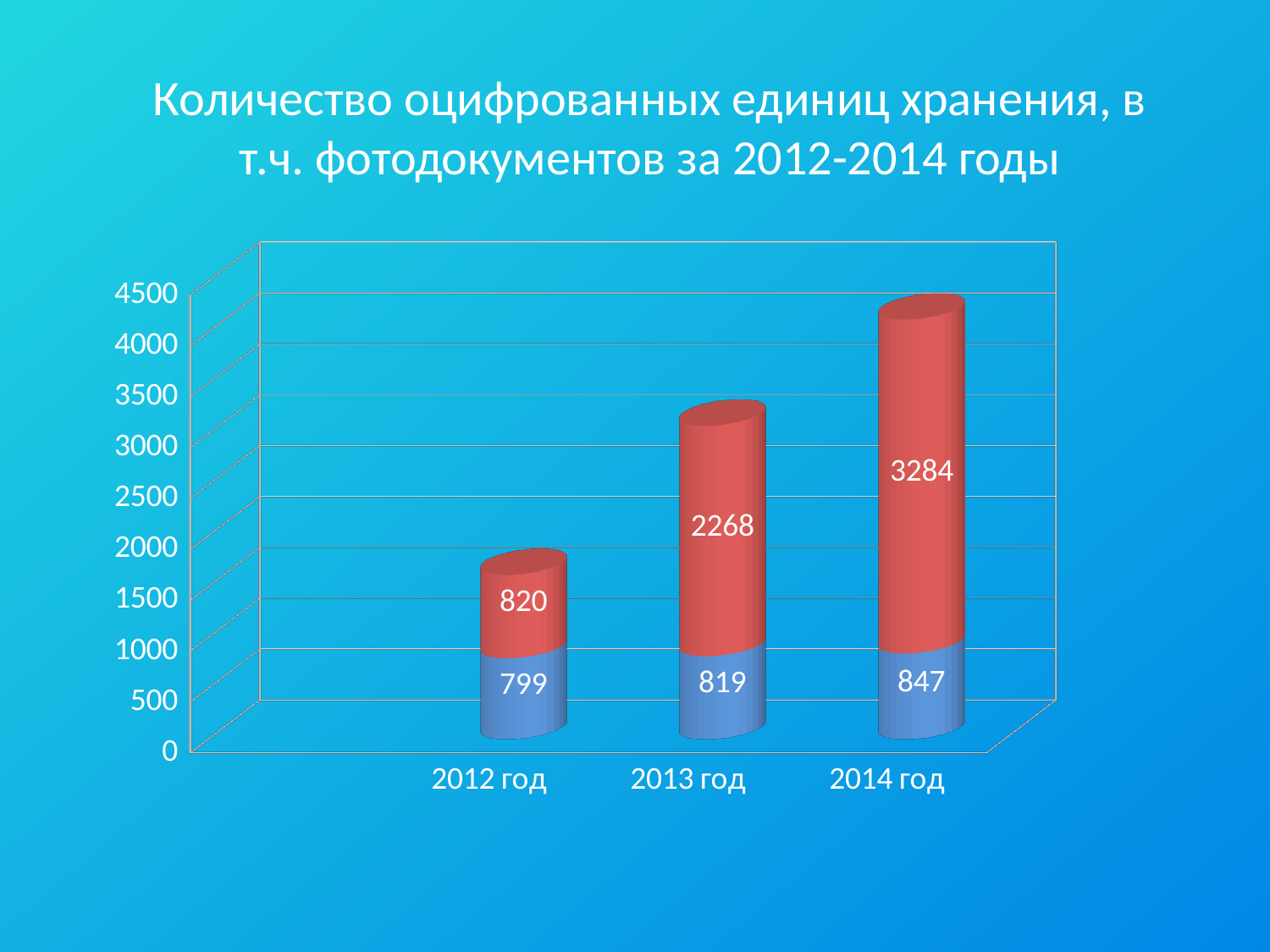
What is the value of the red segment for 2013 год? 2268 What kind of chart is shown on the slide? Stacked bar chart Which year has the highest value for the red segment? 2014 год Do the red segment values rise or fall from 2012 год to 2014 год? Rise What is the value of the red segment for 2014 год? 3284 Which year has the lowest value for the blue segment? 2012 год How many years are shown on the x axis? 3 What is the total of the stacked bar for 2014 год? 4131 What is the total of the stacked bar for 2012 год? 1619 What is the value of the blue segment for 2012 год? 799 Which is larger: the blue segment for 2014 год or the blue segment for 2013 год? 2014 год What is the difference between the red segment values for 2014 год and 2013 год? 1016